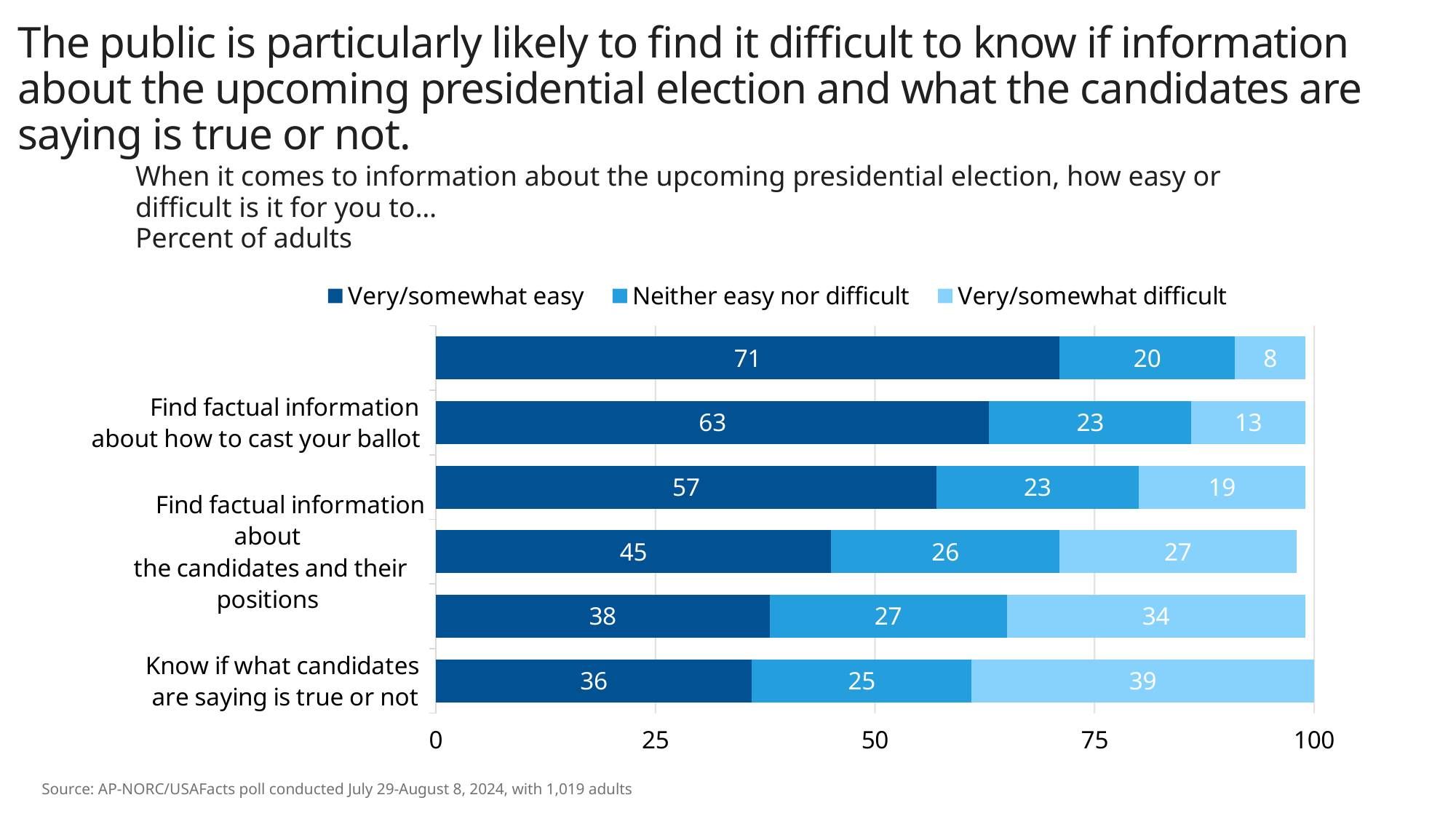
What is the Very/somewhat difficult value for the bottom bar (Know if what candidates are saying is true or not)? 39 What is the Very/somewhat easy value for the top bar? 71 Do the Very/somewhat easy values rise or fall going from the top bar to the bottom bar? Fall What is the total of the three segments in the top bar? 99 What is the Neither easy nor difficult value for the fourth bar from the top? 26 What is the difference between the Very/somewhat difficult value of the bottom bar and that of the top bar? 31 What kind of chart is shown on the slide? Stacked bar chart How many bars are plotted in the chart? 6 Which bar has the highest Very/somewhat easy value? The top bar (71) In the bottom bar, which is larger: the Very/somewhat easy value or the Very/somewhat difficult value? Very/somewhat difficult How many series does the legend list? 3 Which bar has the lowest Very/somewhat difficult value? The top bar (8)